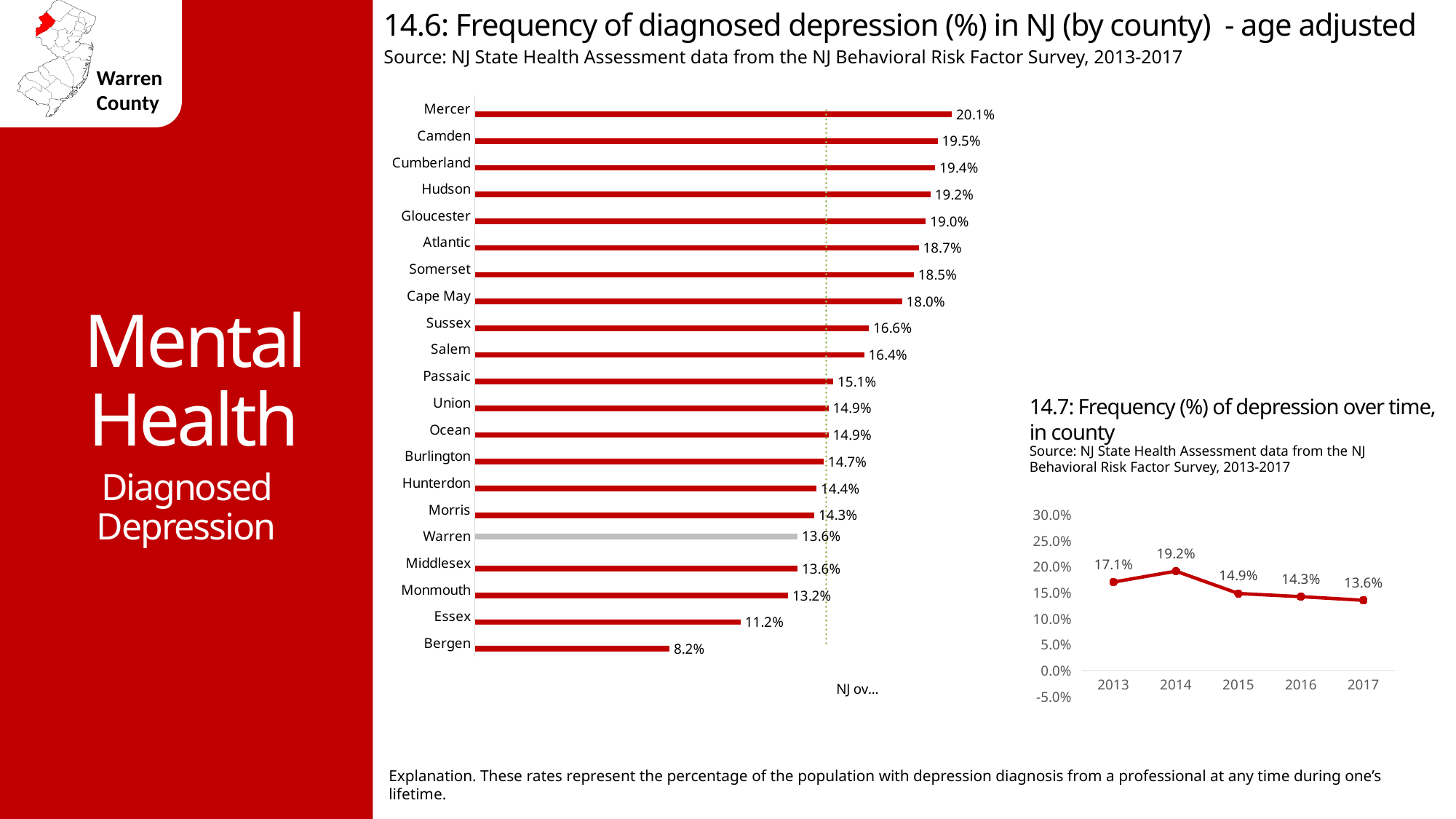
In chart 14.6 (Frequency of diagnosed depression by county), which county's bar is coloured grey instead of red? Warren In chart 14.7 (Frequency of depression over time, in county), what is the value for 2014? 19.2% In chart 14.7 (Frequency of depression over time, in county), how many years are plotted? 5 In chart 14.7 (Frequency of depression over time, in county), do the values rise or fall from 2014 to 2017? Fall In chart 14.6 (Frequency of diagnosed depression by county), which county has the lowest value? Bergen What kind of chart is chart 14.6 (Frequency of diagnosed depression by county)? Bar chart In chart 14.6 (Frequency of diagnosed depression by county), which is larger, the value for Camden or the value for Hudson? Camden In chart 14.6 (Frequency of diagnosed depression by county), what is the value for Essex? 11.2% In chart 14.6 (Frequency of diagnosed depression by county), which county has the highest value? Mercer In chart 14.6 (Frequency of diagnosed depression by county), what is the difference between the values for Mercer and Bergen? 11.9 percentage points In chart 14.6 (Frequency of diagnosed depression by county), what is the value for Warren? 13.6% In chart 14.6 (Frequency of diagnosed depression by county), how many counties are shown? 21